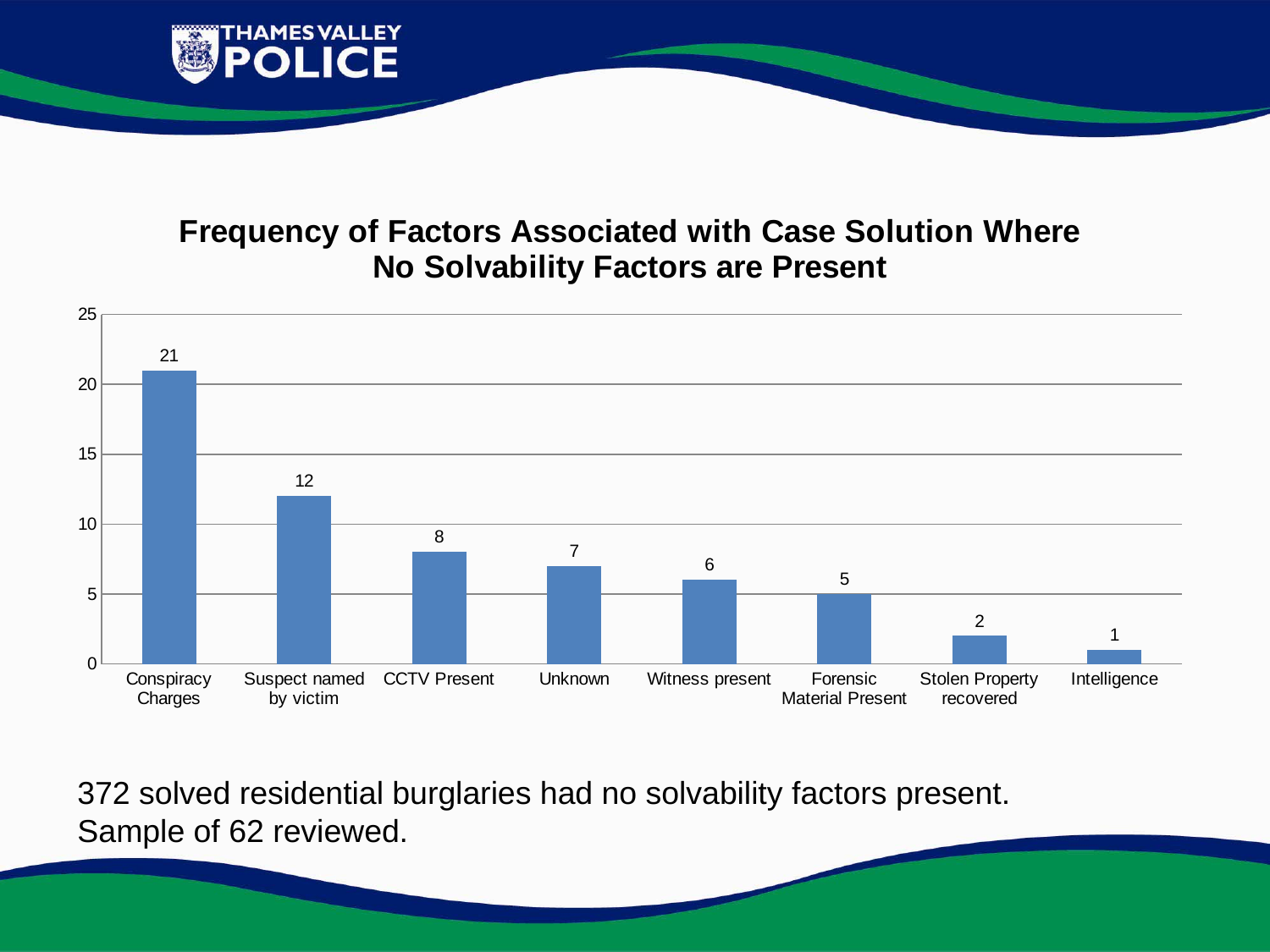
Which category has the lowest value? Intelligence Do the values rise or fall from left to right along the x axis? fall What is the value for Suspect named by victim? 12 What is the difference between the values for CCTV Present and Stolen Property recovered? 6 What kind of chart is shown on the slide? bar chart What is the value for Forensic Material Present? 5 What is the difference between the values for Conspiracy Charges and Suspect named by victim? 9 What is the value for Conspiracy Charges? 21 Which is larger, the value for Unknown or the value for Witness present? Unknown Is the value for CCTV Present greater or less than 10? less Which category has the highest value? Conspiracy Charges How many categories are shown on the x axis? 8